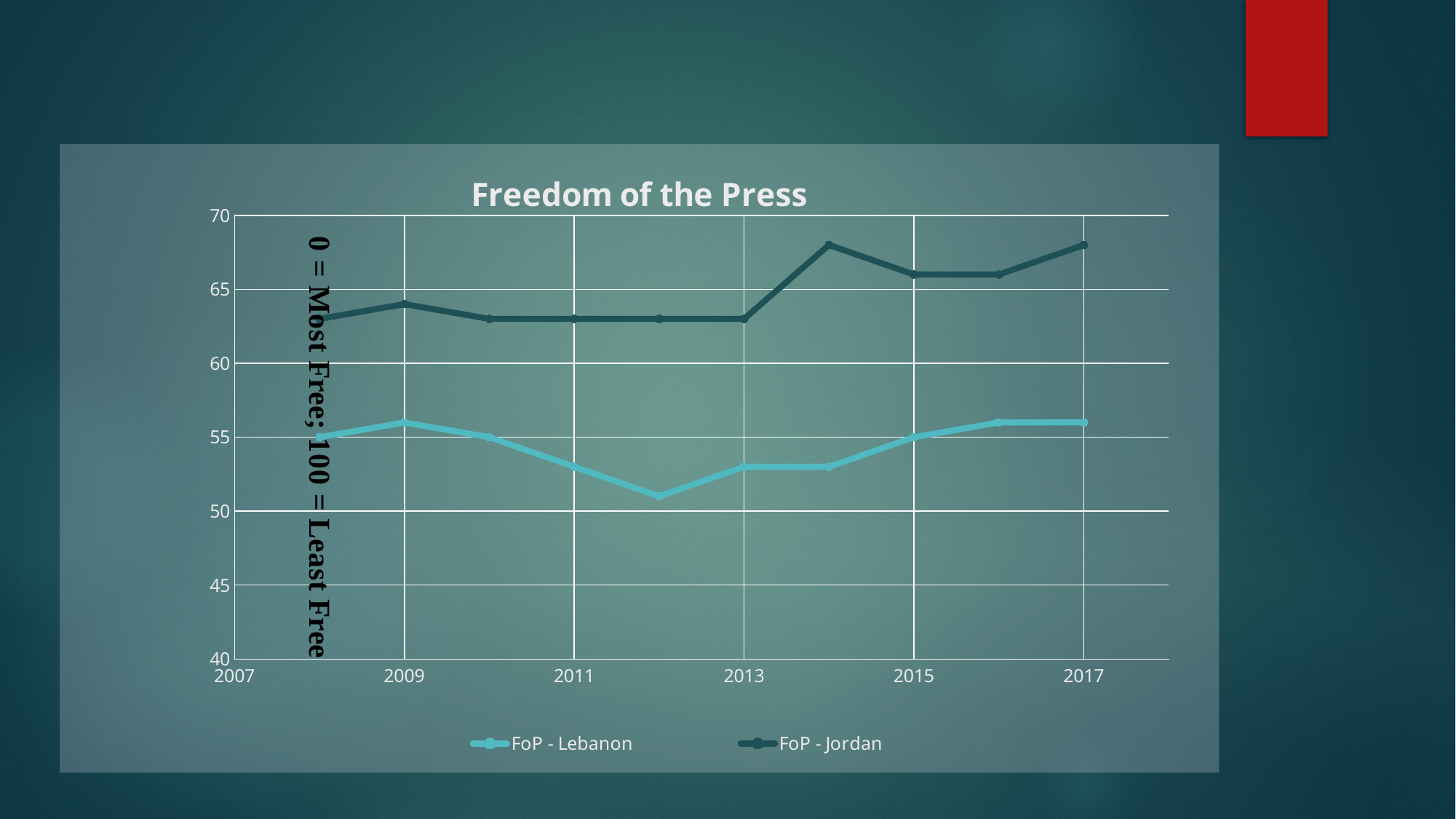
What kind of chart is shown on the slide? line chart What is the title of the chart? Freedom of the Press Is the value for FoP - Jordan in 2014 greater or less than 65? greater Does the FoP - Jordan line rise or fall between 2013 and 2014? rise Does the FoP - Lebanon line rise or fall between 2009 and 2012? fall Is the value for FoP - Lebanon in 2017 greater or less than 60? less Is the value for FoP - Lebanon in 2012 greater or less than 55? less What are the two series named in the legend? FoP - Lebanon and FoP - Jordan In 2017, which series has the higher value, FoP - Lebanon or FoP - Jordan? FoP - Jordan In which year does FoP - Lebanon reach its lowest value? 2012 How many series does the legend list? 2